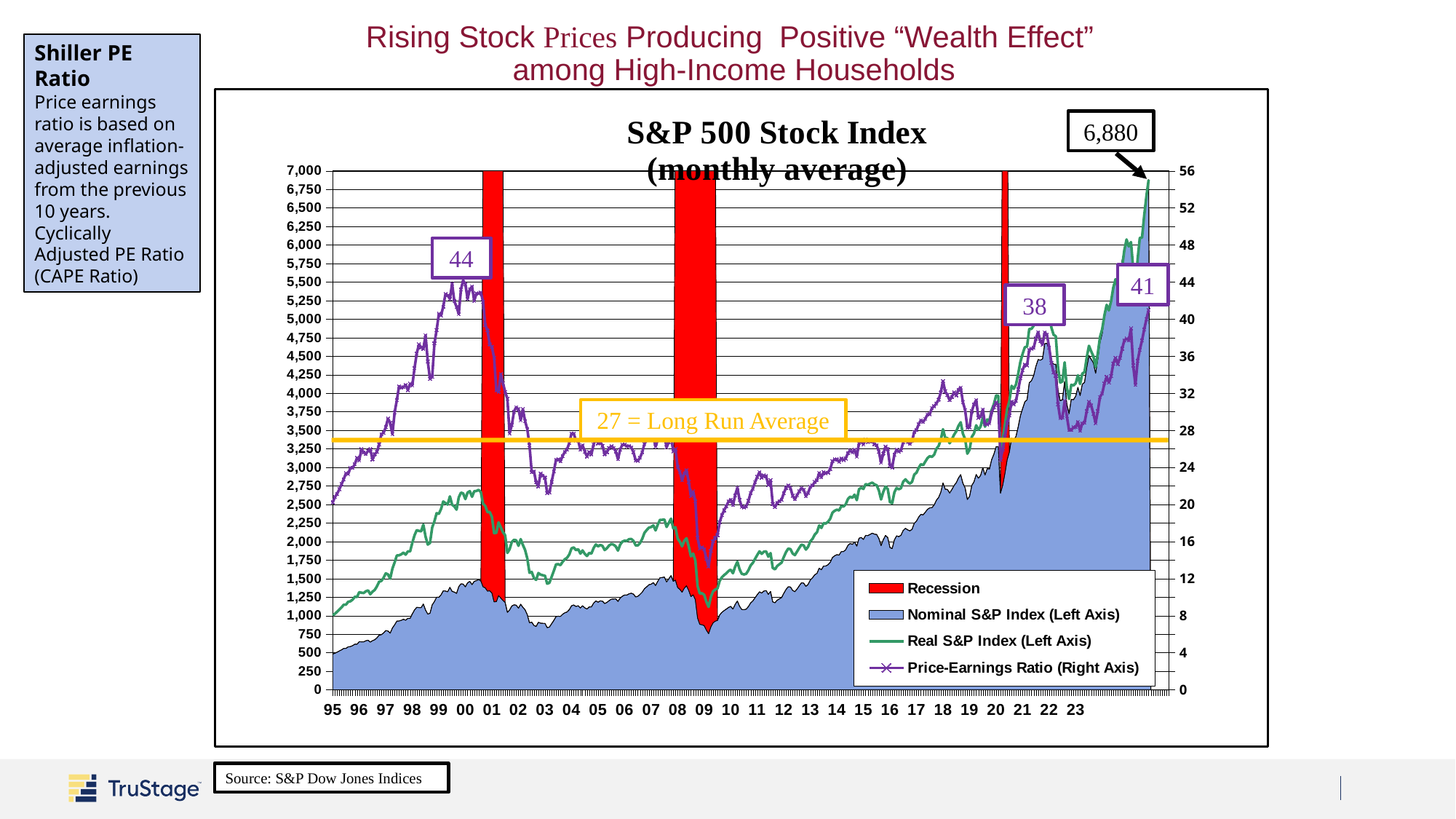
By how much does the labelled Price-Earnings Ratio peak of 44 exceed the long run average of 27? 17 How many entries does the chart legend list? 4 What is the title of the chart? S&P 500 Stock Index (monthly average) How many recession periods are shaded on the chart? 3 What is the latest value of the Nominal S&P Index labelled on the chart? 6,880 What is the labelled peak of the Price-Earnings Ratio around the year 2000? 44 Is the Nominal S&P Index at its 2009 low greater or less than 1,000? less Does the Nominal S&P Index generally rise or fall from 1995 to the end of the chart? rise What value is given as the long run average of the Price-Earnings Ratio? 27 What is the labelled Price-Earnings Ratio value around 2021? 38 Which is larger, the Price-Earnings Ratio labelled 44 around 2000 or the latest labelled value of 41? 44 What is the most recent labelled Price-Earnings Ratio value at the right end of the chart? 41